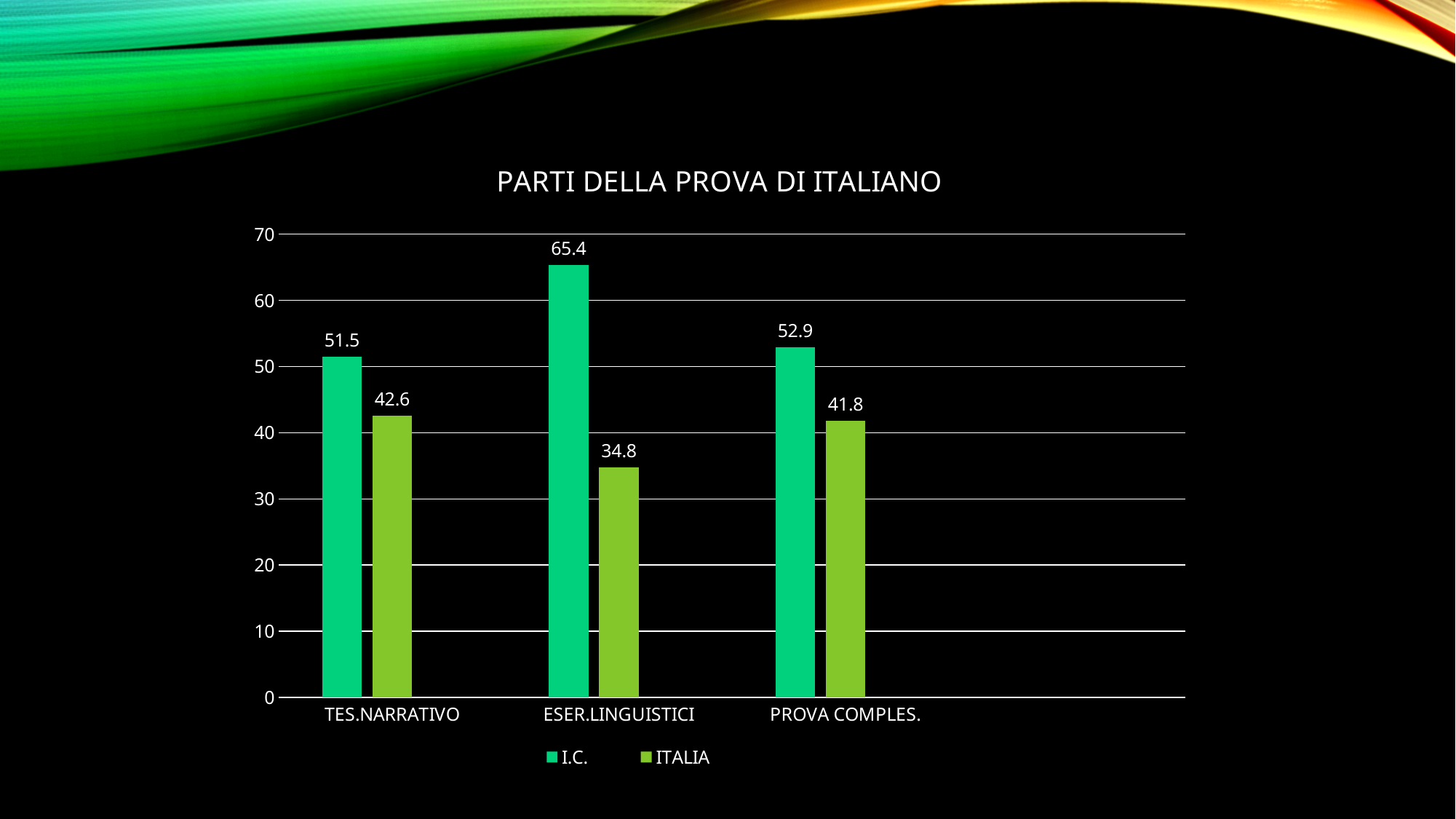
What is the difference between the I.C. and ITALIA values for ESER.LINGUISTICI? 30.6 Is the ITALIA value for ESER.LINGUISTICI greater or less than 40? less What is the ITALIA value for TES.NARRATIVO? 42.6 What is the ITALIA value for PROVA COMPLES.? 41.8 Which category has the lowest ITALIA value? ESER.LINGUISTICI What type of chart is shown on the slide? Bar chart Which is larger for PROVA COMPLES., the I.C. value or the ITALIA value? I.C. How many series does the legend list? 2 What is the difference between the I.C. and ITALIA values for TES.NARRATIVO? 8.9 Which category has the highest I.C. value? ESER.LINGUISTICI How many categories are shown on the x axis? 3 What is the I.C. value for ESER.LINGUISTICI? 65.4